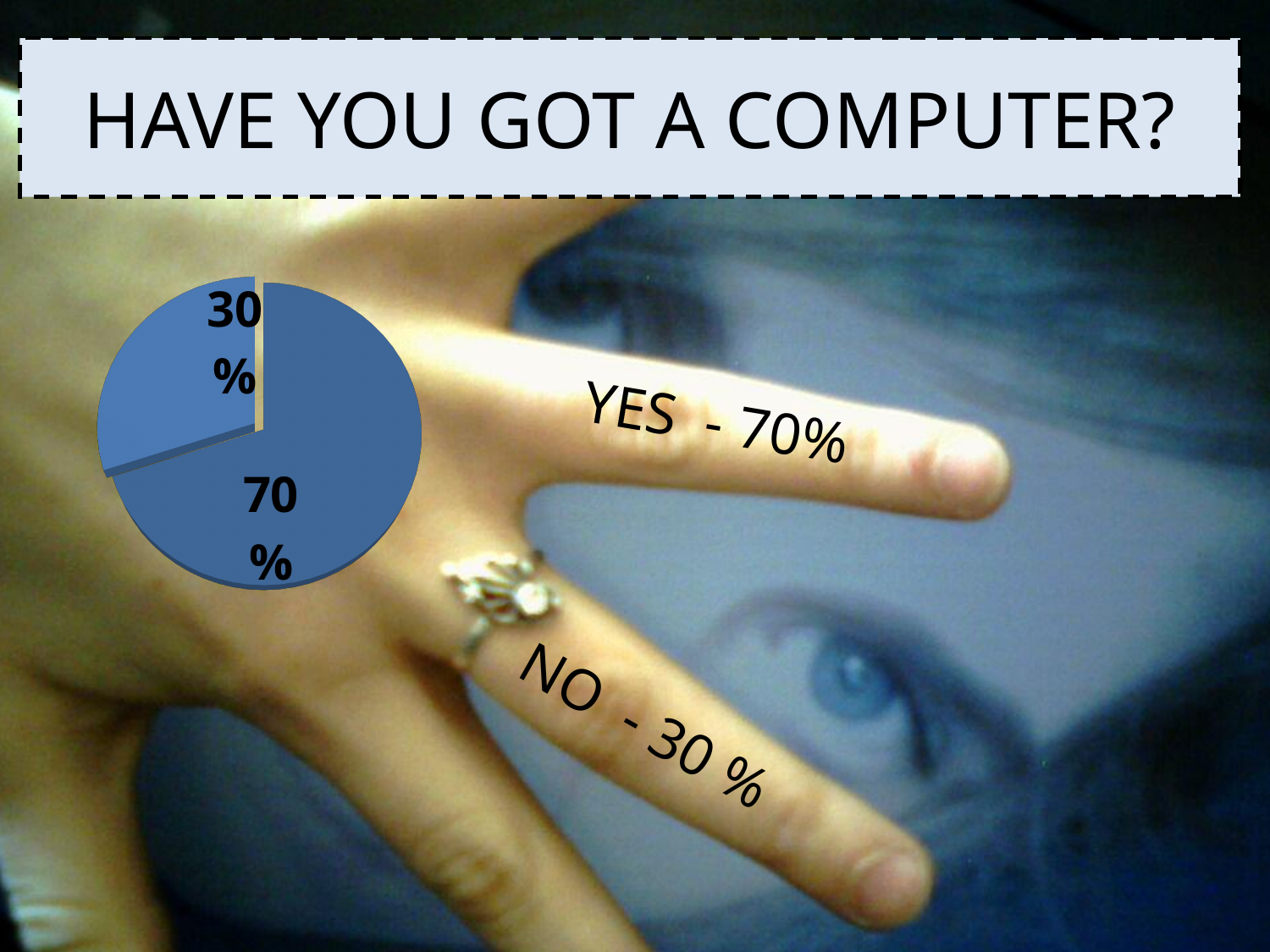
According to the slide, what percentage answered YES? 70% What share of the pie does the larger slice represent? 70% What question is the chart on the slide about? HAVE YOU GOT A COMPUTER? What kind of chart is shown on the slide? pie chart Is the share for YES larger than the share for NO? Yes What is the difference in percentage points between the YES and NO shares? 40 Which answer has the smaller share of the pie, YES or NO? NO Which answer has the larger share of the pie, YES or NO? YES How many slices does the pie chart have? 2 What share of the pie does the smaller slice represent? 30% According to the slide, what percentage answered NO? 30 % What colour are the slices of the pie chart? blue